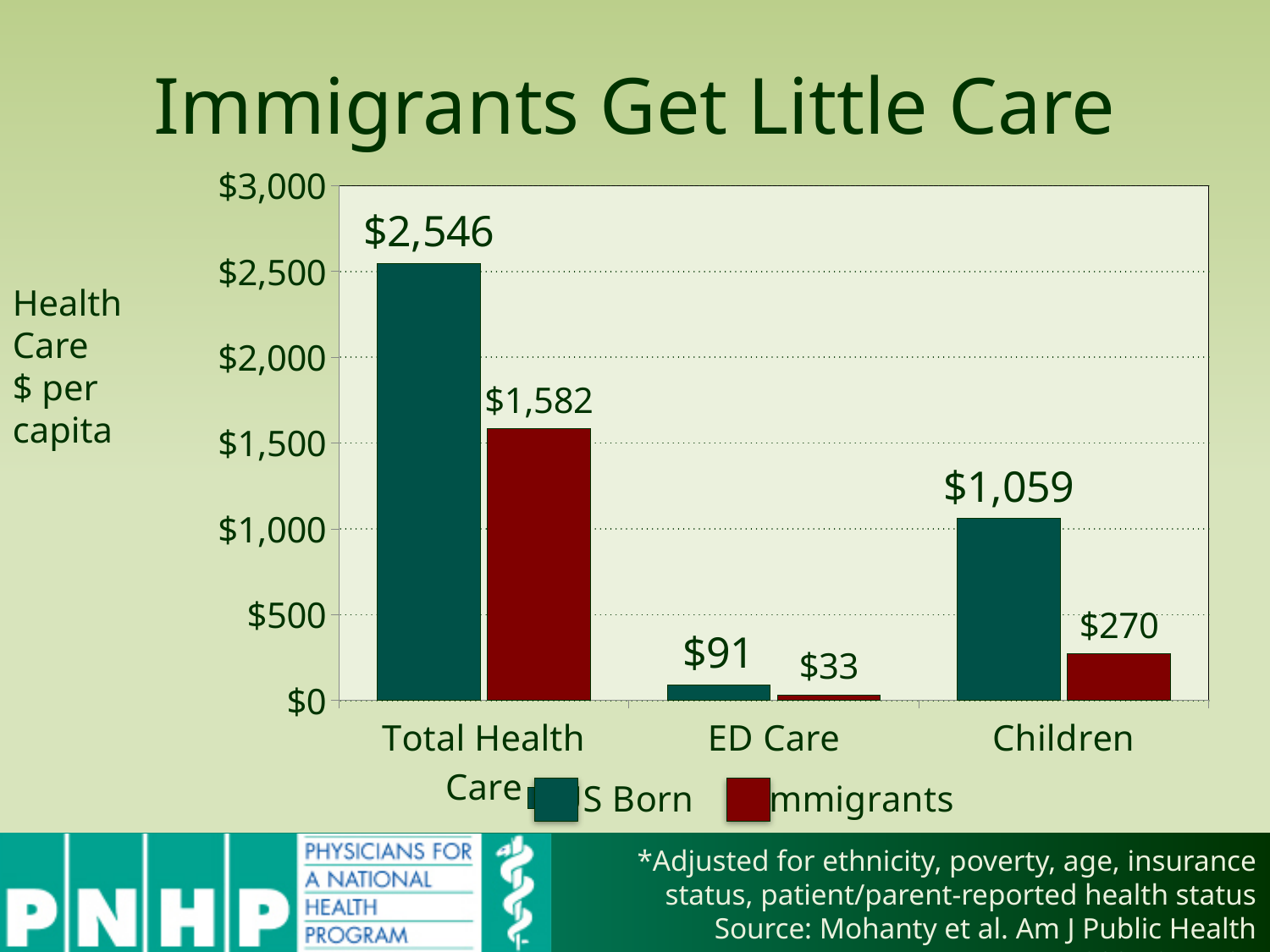
Which is larger in the ED Care category, the US Born value or the Immigrants value? US Born What kind of chart is shown on the slide? bar chart How many categories are shown on the x axis? 3 What is the value for Immigrants in the Children category? $270 How many series does the legend list? 2 Is the value for Immigrants in the Total Health Care category greater or less than $1,500? greater What is the difference between the US Born and Immigrants values in the Total Health Care category? $964 Which category has the highest value for US Born? Total Health Care What is the difference between the US Born and Immigrants values in the Children category? $789 What is the value for US Born in the Total Health Care category? $2,546 What is the value for Immigrants in the ED Care category? $33 Which category has the lowest value for Immigrants? ED Care